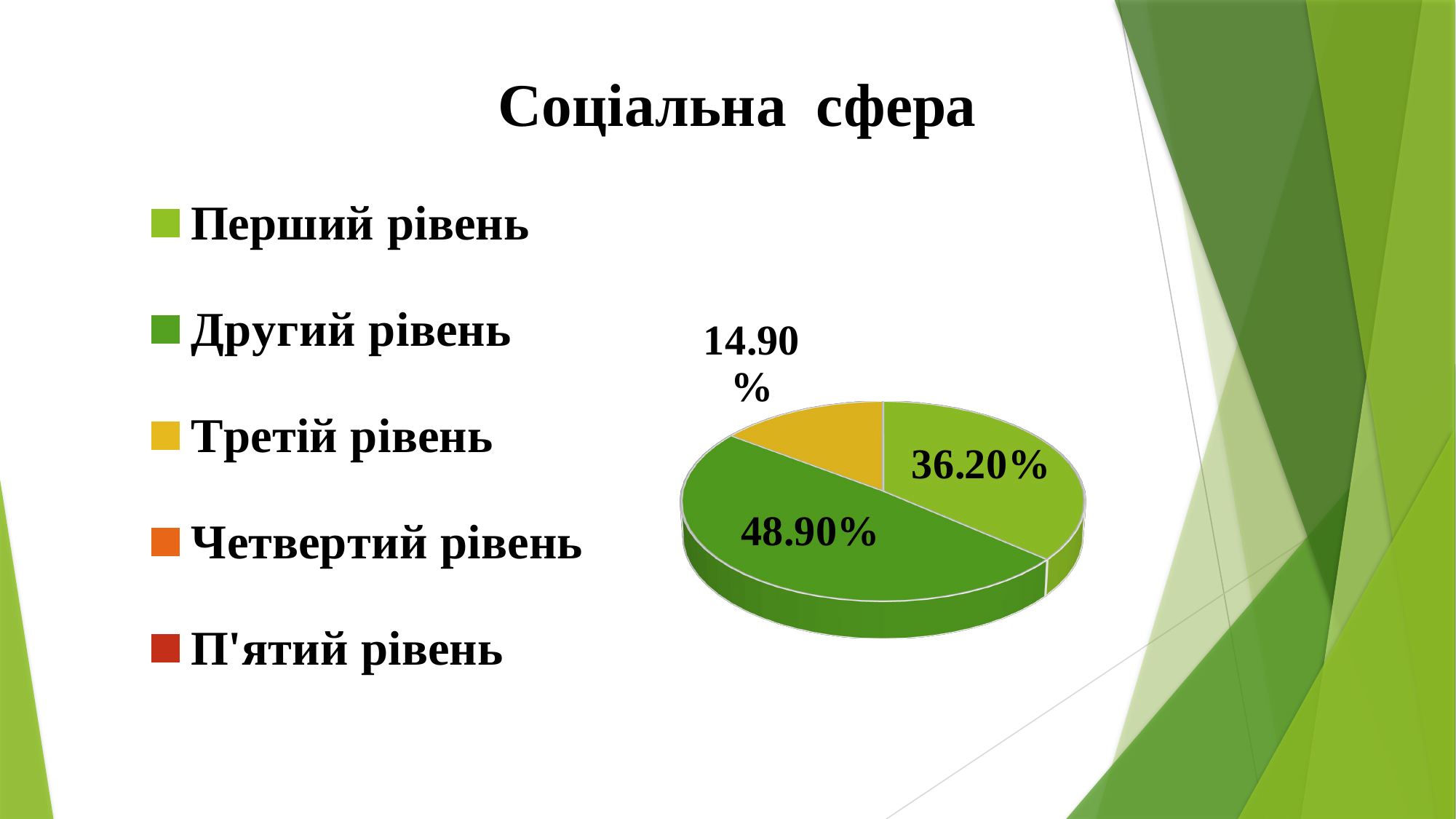
How many entries does the legend list? 5 What share of the pie does Другий рівень have? 48.90% How many slices with data labels are shown in the pie? 3 Which category has the largest slice of the pie? Другий рівень Which is larger, the slice for Перший рівень or the slice for Третій рівень? Перший рівень What kind of chart is shown on the slide? pie chart What is the difference between the shares of Другий рівень and Перший рівень? 12.70% What is the title of the chart? Соціальна сфера Which of the labelled slices is the smallest? Третій рівень What share of the pie does Перший рівень have? 36.20% What share of the pie does Третій рівень have? 14.90% What is the difference between the shares of Перший рівень and Третій рівень? 21.30%